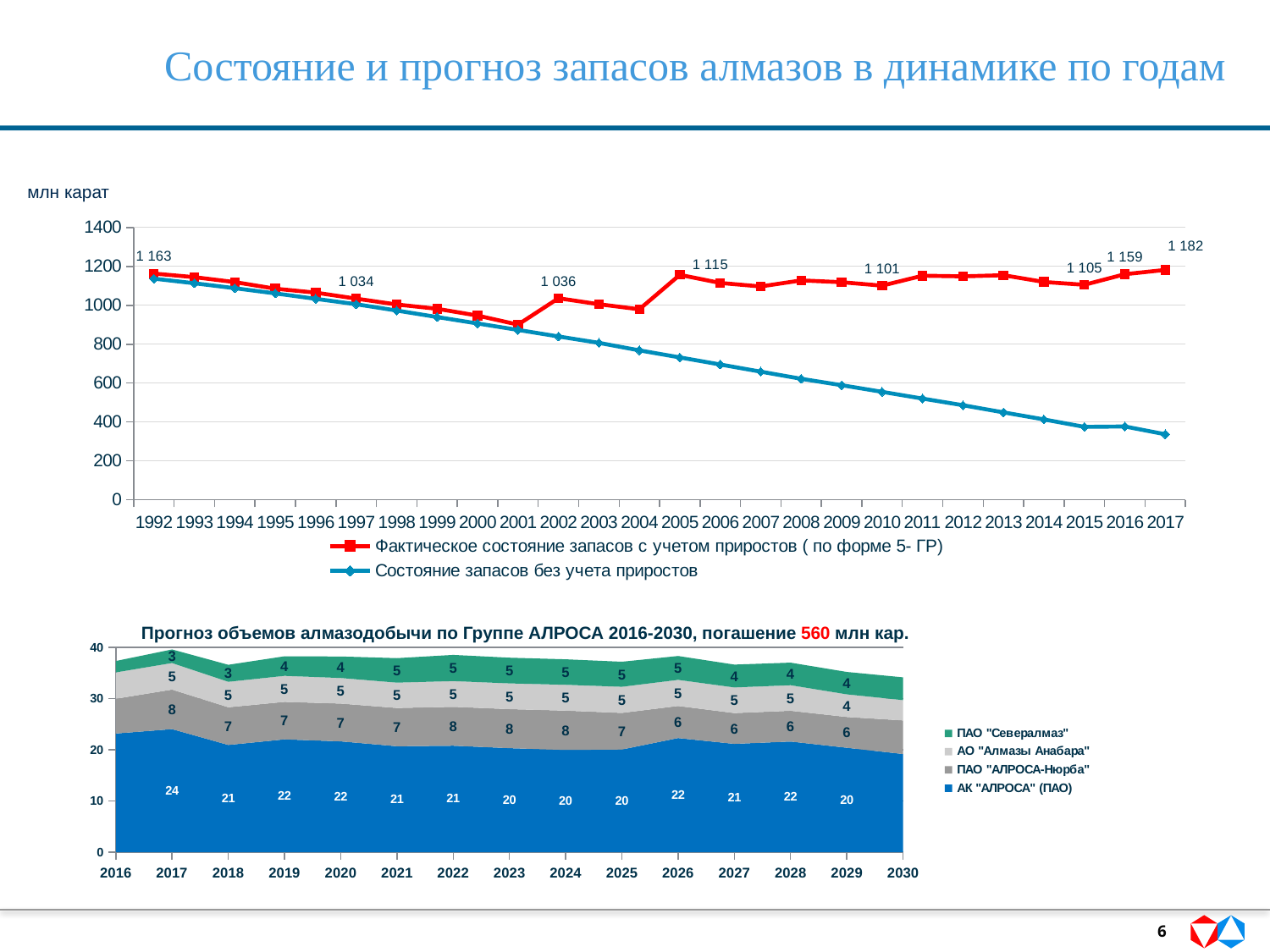
In the top chart, what is the value of 'Фактическое состояние запасов с учетом приростов' in 1992? 1 163 In the top chart, what is the value of 'Фактическое состояние запасов с учетом приростов' in 2017? 1 182 In the bottom chart, what is the total of all four series in 2017? 40 In the top chart, is the 2017 value of 'Состояние запасов без учета приростов' greater or less than 400? less In the top chart, which is larger for the red series: the value in 2005 or the value in 2010? 2005 How many series does the legend of the bottom chart list? 4 What kind of chart is the top chart on the slide? line chart In the top chart, does the series 'Состояние запасов без учета приростов' rise or fall from 1992 to 2017? fall In the bottom chart, what is the value for АК "АЛРОСА" (ПАО) in 2017? 24 How many series does the legend of the top chart list? 2 In the top chart, what is the difference between the 2017 value (1 182) and the 1992 value (1 163) of the red series? 19 In the bottom chart, what is the value for ПАО "АЛРОСА-Нюрба" in 2029? 6